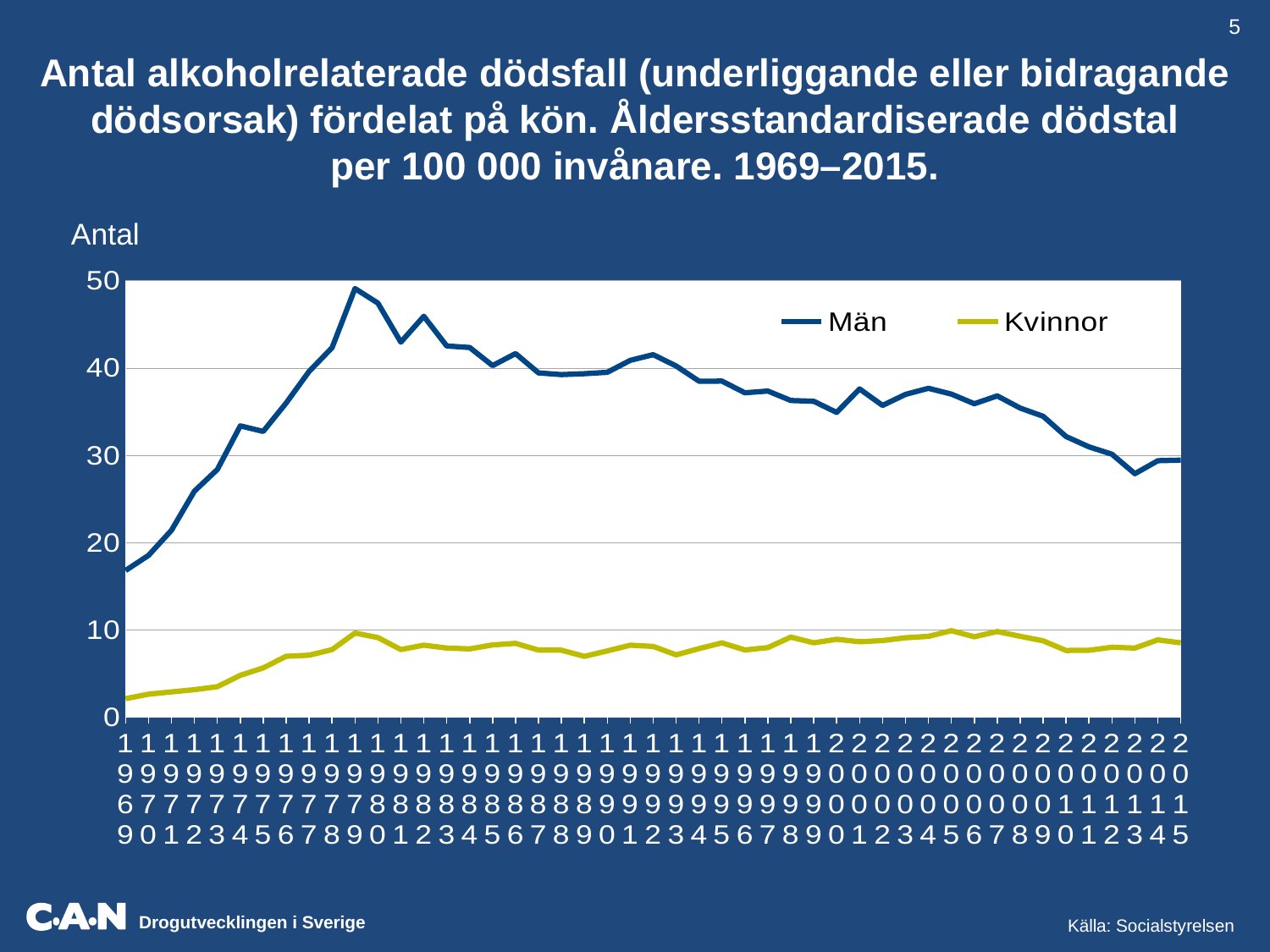
In which year is the Kvinnor series at its lowest value? 1969 Is the value for Män in 2013 greater or less than 30? less What are the two series named in the legend? Män and Kvinnor How many series does the legend list? 2 Is the value for Män in 1969 greater or less than 20? less Which series has the higher value in 2000, Män or Kvinnor? Män What is the label on the vertical axis? Antal What kind of chart is shown on the slide? line chart In which year does the Män series reach its highest value? 1979 In which year is the Män series at its lowest value? 1969 Is the value for Män in 1979 greater or less than 40? greater Does the Män series rise or fall between 1969 and 1979? rise